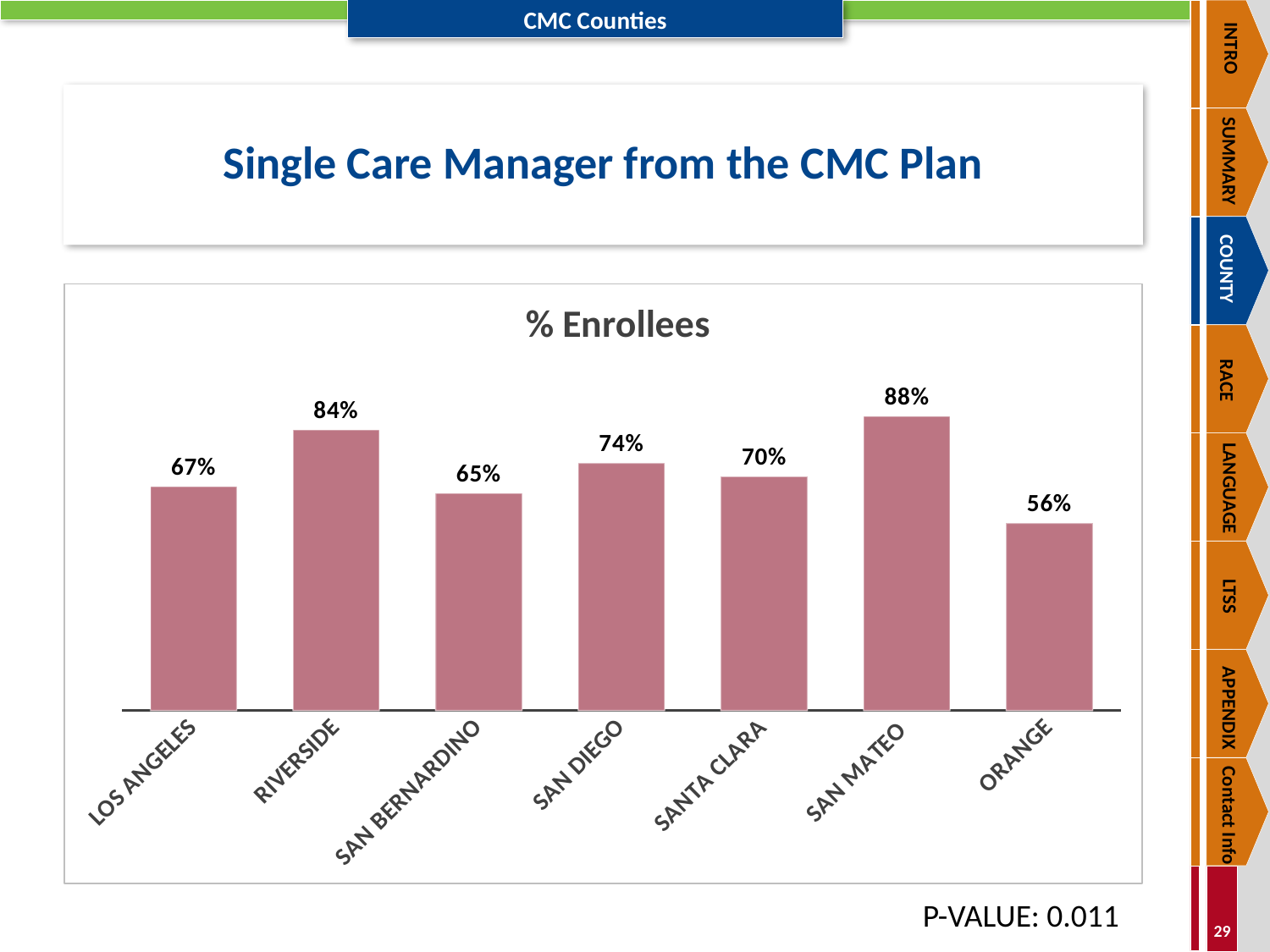
Which county has the lowest value? Orange What is the value for Orange? 56% Which county has the highest value? San Mateo What is the value for Riverside? 84% Which is larger, the value for Los Angeles or the value for San Diego? San Diego What is the value for San Bernardino? 65% What is the difference between the values for San Diego and Santa Clara? 4% How many counties are shown in the chart? 7 What p-value is shown below the chart? 0.011 What is the title of the chart? % Enrollees What is the difference between the values for San Mateo and Orange? 32% What kind of chart is shown? Bar chart